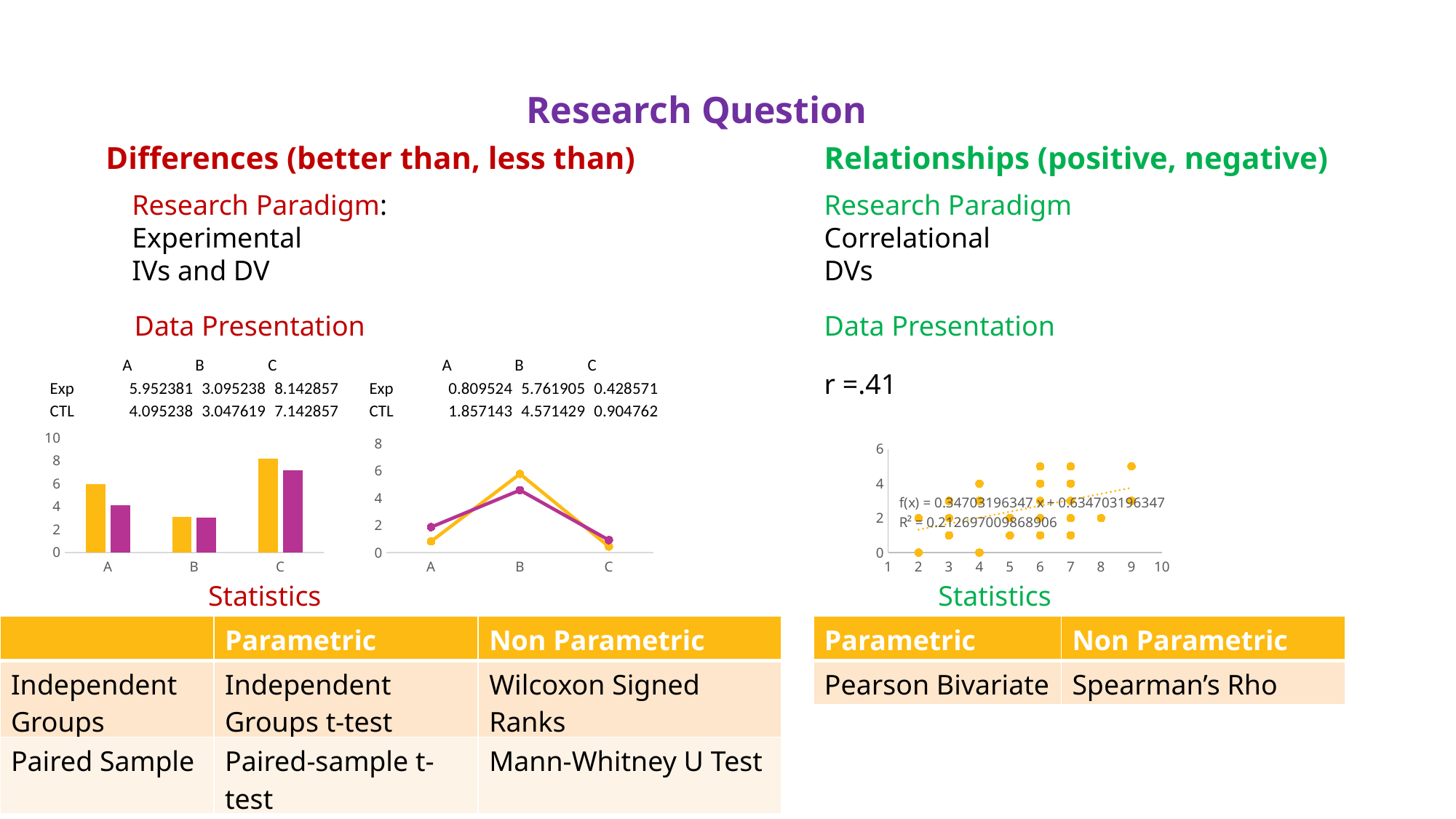
In the bar chart on the left, which category has the highest Exp value? C In the middle line chart, what is the CTL value for category B? 4.571429 What kind of chart is the leftmost chart under Data Presentation on the Differences side? bar chart What R² value is printed on the scatter plot on the right? 0.212697009868906 In the middle line chart, at which category does the Exp series reach its highest value? B How many categories are shown on the x axis of the bar chart on the left? 3 What kind of chart is shown under Data Presentation on the Relationships side? scatter plot In the bar chart on the left, what is the difference between the Exp and CTL values for category C? 1 In the middle line chart, do the values rise or fall from B to C? fall What kind of chart is the middle chart (the one with categories A, B, C and values up to 8)? line chart In the bar chart on the left, which is larger for category A, Exp or CTL? Exp In the bar chart on the left, what is the Exp value for category C? 8.142857